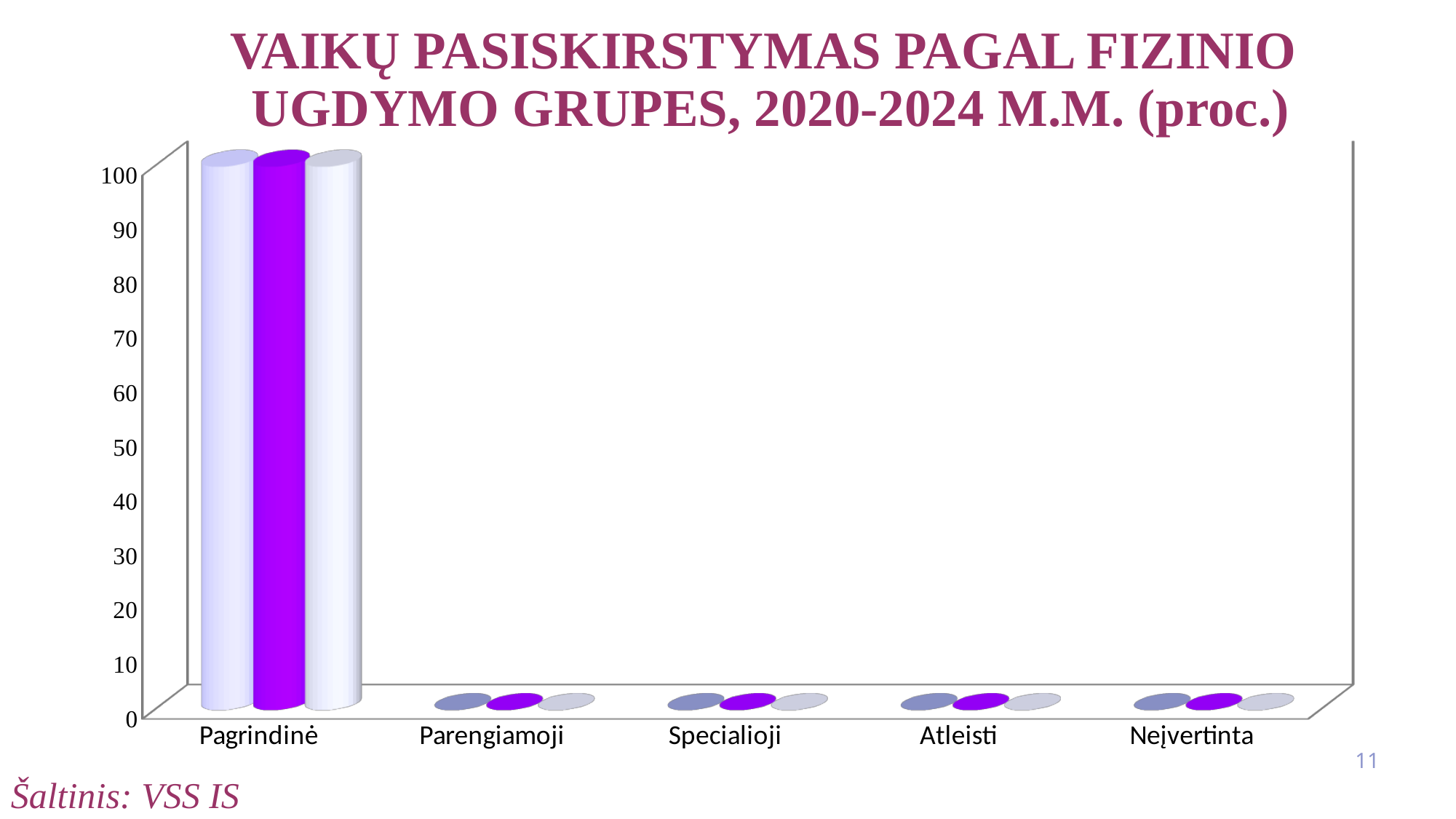
Are the values for Parengiamoji greater or less than 10? less Which category has larger values, Atleisti or Pagrindinė? Pagrindinė What is the highest value shown on the y axis of the chart? 100 Which category has larger values, Pagrindinė or Specialioji? Pagrindinė What is the source cited below the chart? VSS IS Are the values for Pagrindinė greater or less than 90? greater Which category has the highest values in the chart? Pagrindinė Are the values for Neįvertinta greater or less than 10? less What kind of chart is shown on the slide? bar chart How many categories are shown on the x axis of the chart? 5